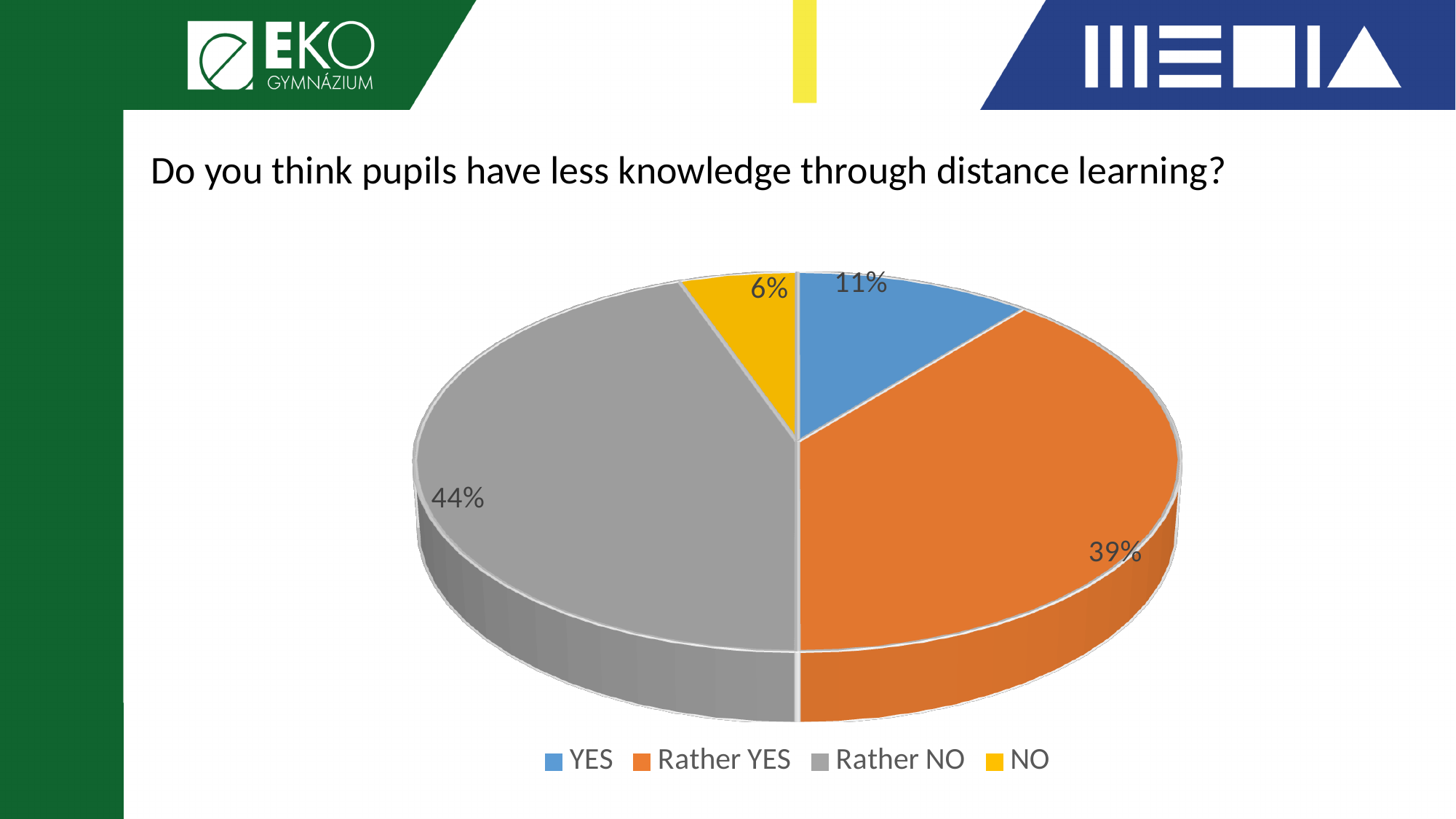
What percentage of respondents answered "Rather YES"? 39% Which answer has the largest share of the pie? Rather NO What percentage of respondents answered "Rather NO"? 44% What question is the chart titled with? Do you think pupils have less knowledge through distance learning? What percentage of respondents answered "YES"? 11% What is the difference in percentage points between "Rather NO" and "Rather YES"? 5 Which is larger, the share for "YES" or the share for "NO"? YES How many categories does the pie chart show? 4 What is the combined share of "YES" and "Rather YES"? 50% Which answer has the smallest share of the pie? NO What kind of chart is shown on the slide? pie chart What percentage of respondents answered "NO"? 6%